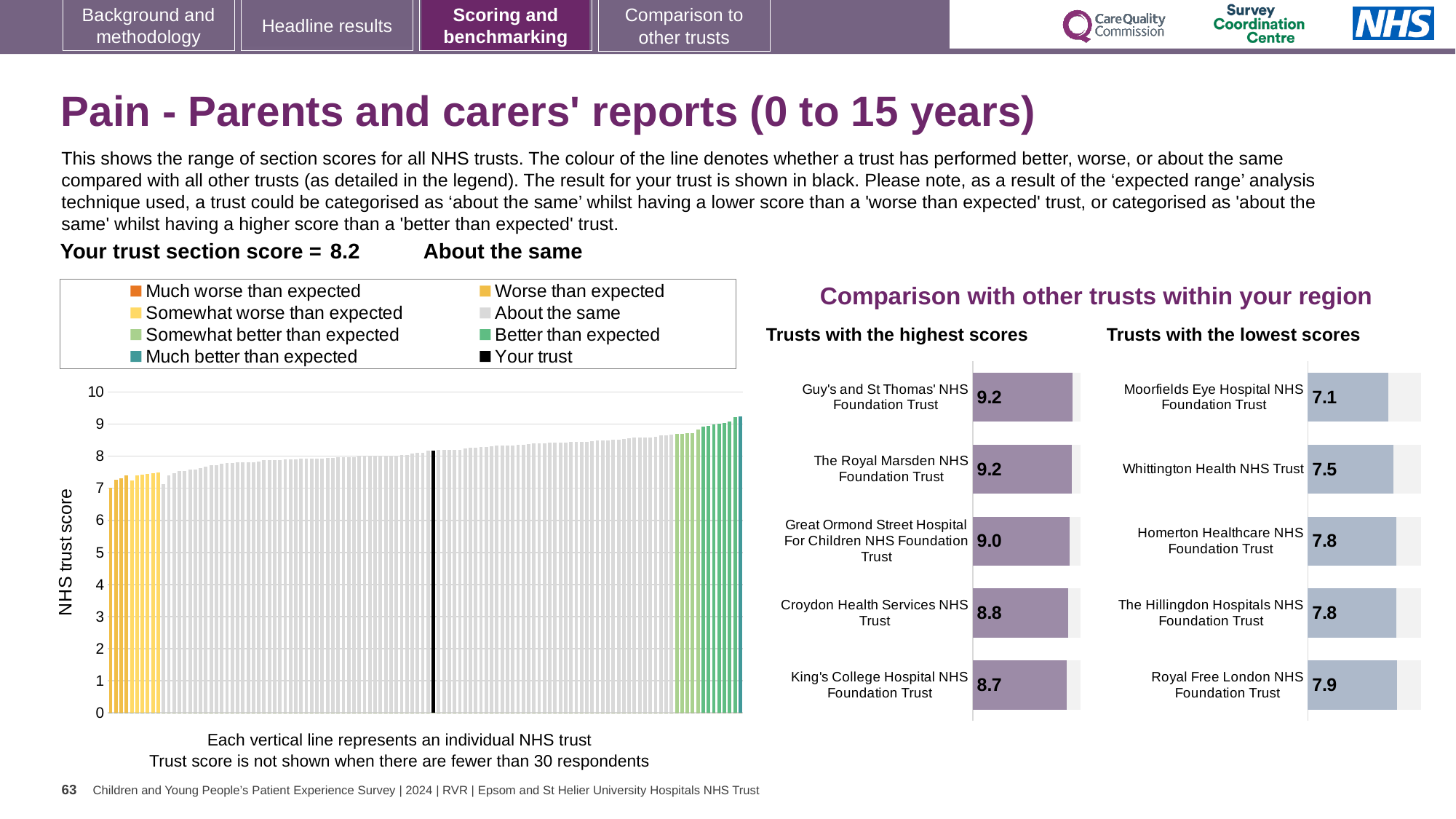
How many entries does the legend of the main NHS trust score chart list? 8 In the 'Trusts with the lowest scores' chart, how much higher is Royal Free London NHS Foundation Trust's score than Moorfields Eye Hospital NHS Foundation Trust's? 0.8 In the main NHS trust score chart, do the values rise or fall from left to right along the x axis? rise In the 'Trusts with the highest scores' chart, which trust has the lowest score? King's College Hospital NHS Foundation Trust In the 'Trusts with the lowest scores' chart, what is the score for Whittington Health NHS Trust? 7.5 In the 'Trusts with the highest scores' chart, which has the higher score: Great Ormond Street Hospital For Children NHS Foundation Trust or Croydon Health Services NHS Trust? Great Ormond Street Hospital For Children NHS Foundation Trust In the 'Trusts with the highest scores' chart, what is the difference between the scores of Guy's and St Thomas' NHS Foundation Trust and King's College Hospital NHS Foundation Trust? 0.5 In the 'Trusts with the highest scores' chart, what is the score for Croydon Health Services NHS Trust? 8.8 How many trusts are shown in the 'Trusts with the highest scores' chart? 5 In the 'Trusts with the lowest scores' chart, which trust has the highest score? Royal Free London NHS Foundation Trust In the 'Trusts with the lowest scores' chart, which trust has the lowest score? Moorfields Eye Hospital NHS Foundation Trust What kind of chart is the main chart showing NHS trust scores on the left of the slide? bar chart